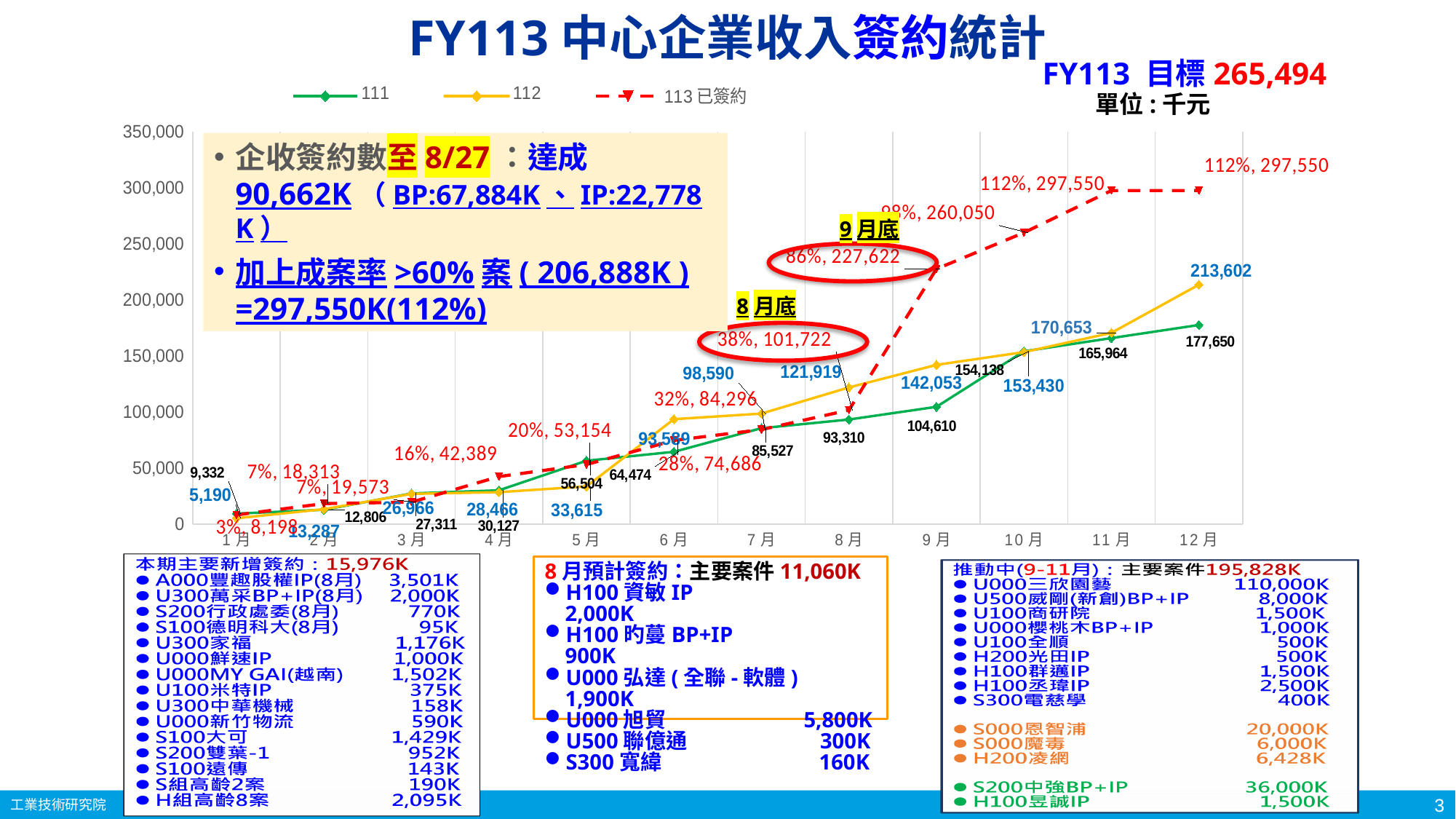
What is the difference between the 112 and 111 series values at 12月? 35,952 In which month does the 112 series reach its highest value? 12月 How many months are shown along the x axis of the chart? 12 What is the value of the 112 series at 12月? 213,602 At 5月, which series has the larger value, 111 or 112? 111 What value is labelled for the 113 已簽約 series at 8月底? 38%, 101,722 What is the FY113 目標 value stated on the slide? 265,494 What kind of chart is shown on the slide? line chart Is the value of the 112 series at 8月 greater or less than 100,000? greater How many series does the chart legend list? 3 What value is labelled for the 113 已簽約 series at 9月底? 86%, 227,622 What is the value of the 111 series at 12月? 177,650